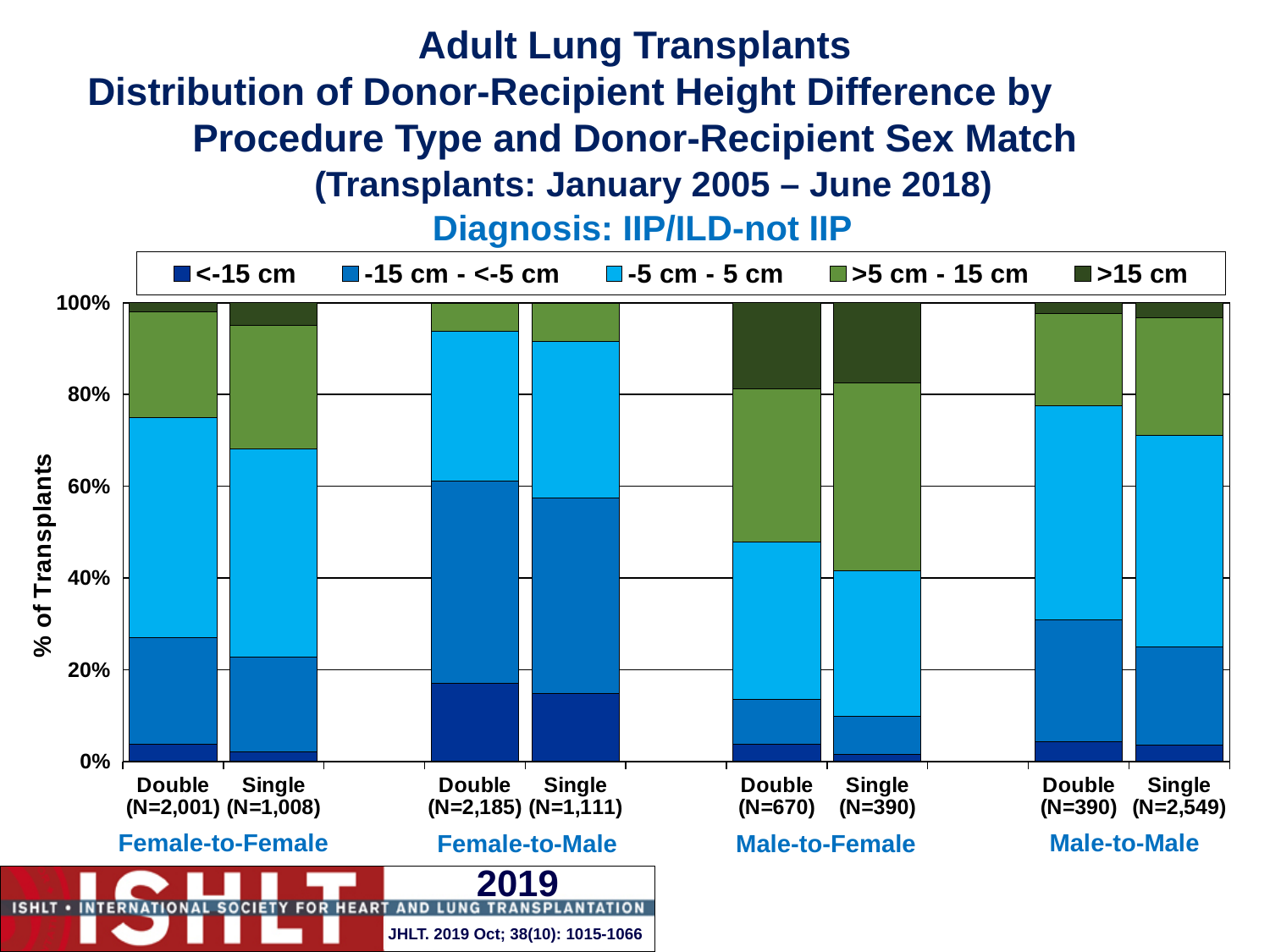
What is the N for the Male-to-Male Single bar? 2,549 What is the N for the Female-to-Male Double bar? 2,185 Which bar has a larger <-15 cm share: Female-to-Male Double or Female-to-Female Double? Female-to-Male Double Is the share of the <-15 cm category for the Female-to-Female Single bar greater or less than 20%? less Is the share of the -5 cm - 5 cm category for the Female-to-Female Double bar greater or less than 40%? greater Which bar has a larger >15 cm share: Male-to-Female Double or Female-to-Female Double? Male-to-Female Double What kind of chart is shown on the slide? Stacked bar chart What is the diagnosis stated in the chart title? IIP/ILD-not IIP How many bars are plotted in the chart? 8 How many series does the legend list? 5 What is the label of the y-axis? % of Transplants Is the share of the >5 cm - 15 cm category for the Male-to-Female Double bar greater or less than 20%? greater